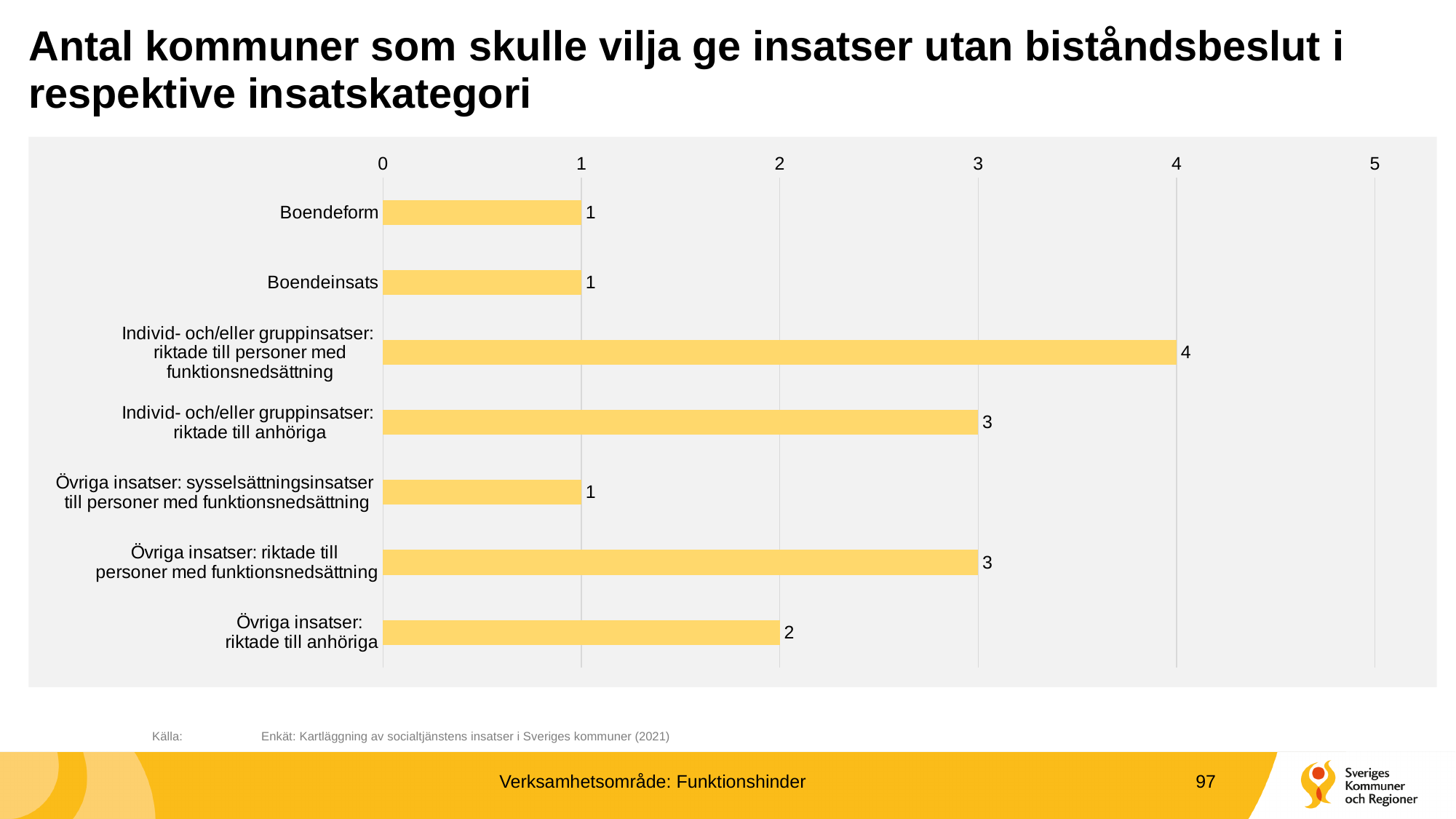
Is the value for Individ- och/eller gruppinsatser: riktade till personer med funktionsnedsättning greater or less than 2? greater What is the value for Övriga insatser: riktade till anhöriga? 2 Which category has the highest value? Individ- och/eller gruppinsatser: riktade till personer med funktionsnedsättning How many categories are shown in the chart? 7 What is the value for Boendeinsats? 1 What kind of chart is shown on the slide? bar chart What is the value for Individ- och/eller gruppinsatser: riktade till anhöriga? 3 What is the difference between the values for Individ- och/eller gruppinsatser: riktade till personer med funktionsnedsättning and Övriga insatser: riktade till anhöriga? 2 Which is larger, the value for Övriga insatser: riktade till personer med funktionsnedsättning or the value for Övriga insatser: riktade till anhöriga? Övriga insatser: riktade till personer med funktionsnedsättning What is the maximum value shown on the horizontal axis? 5 What is the value for Boendeform? 1 How many categories have a value of 1? 3